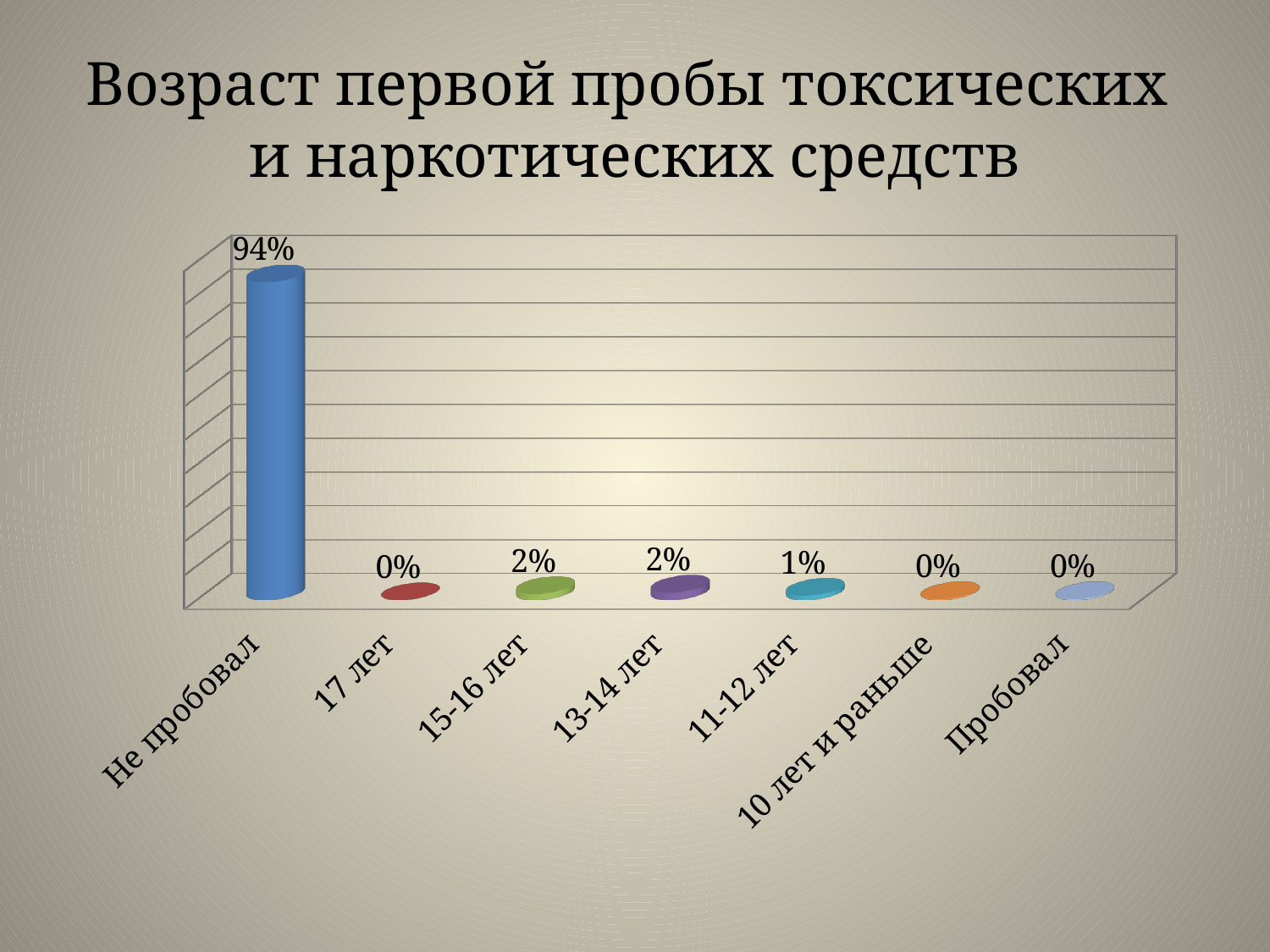
What is the difference between the values for "Не пробовал" and "15-16 лет"? 92% Which is larger, the value for "15-16 лет" or the value for "11-12 лет"? 15-16 лет What is the value for "13-14 лет"? 2% What is the value for "17 лет"? 0% What is the title of the chart on the slide? Возраст первой пробы токсических и наркотических средств What kind of chart is shown on the slide? Bar chart What is the value for "Не пробовал"? 94% What is the value for "11-12 лет"? 1% How many categories are shown on the x axis? 7 What is the difference between the values for "13-14 лет" and "11-12 лет"? 1% What is the value for "15-16 лет"? 2% Which category has the highest value? Не пробовал